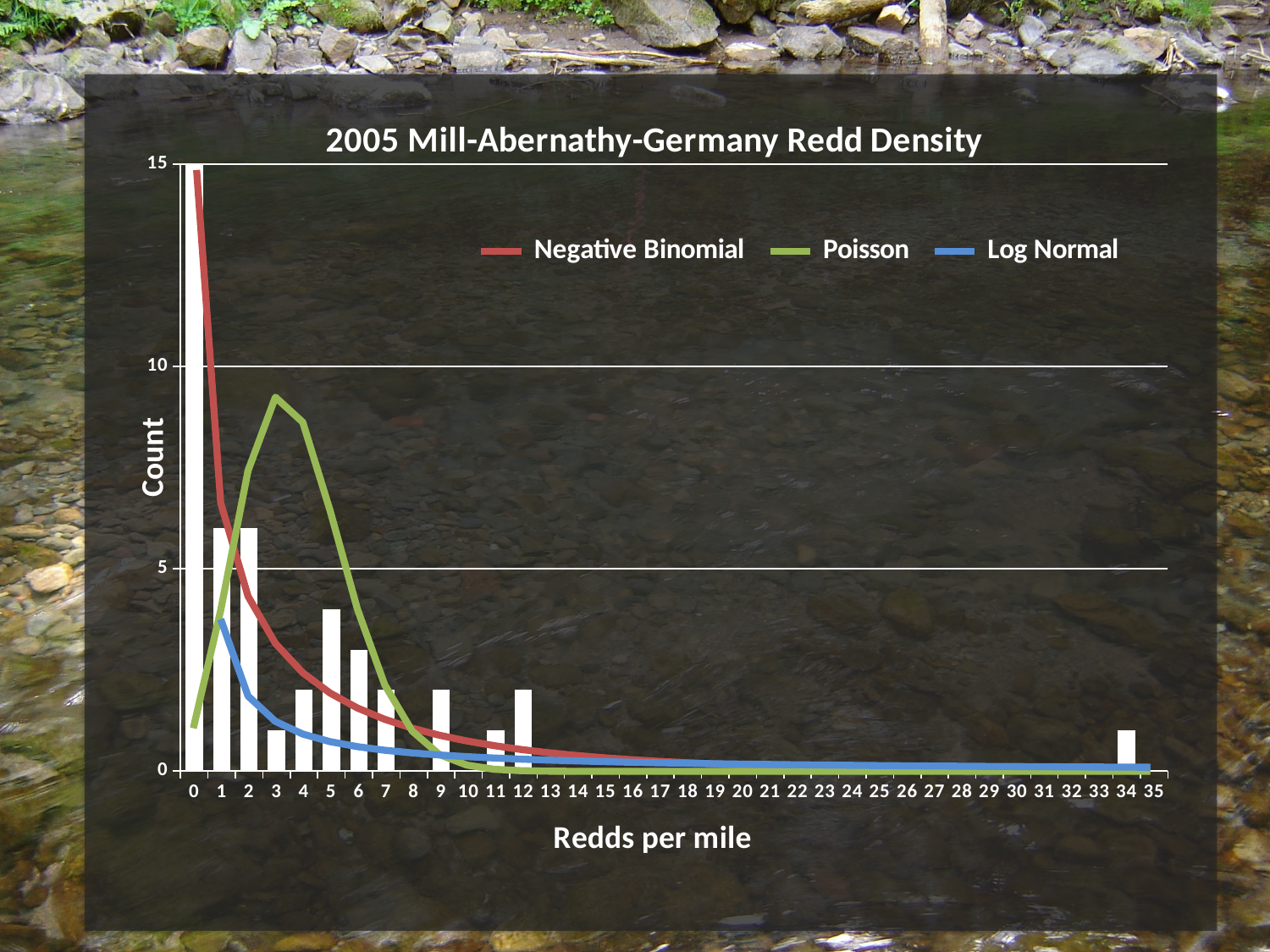
What is the label of the x axis? Redds per mile Which bar is taller, the one for 5 redds per mile or the one for 3 redds per mile? 5 redds per mile How many series does the legend list? 3 Does the Negative Binomial line rise or fall as redds per mile increase from 0 to 35? fall At which redds-per-mile value does the Poisson line reach its peak? 3 Is the bar for 0 redds per mile greater or less than 10? greater Is the bar for 5 redds per mile greater or less than 5? less Is the peak of the Poisson line greater or less than 10? less What is the title of the chart? 2005 Mill-Abernathy-Germany Redd Density Which bar is taller, the one for 1 redd per mile or the one for 6 redds per mile? 1 redd per mile Which redds-per-mile category has the tallest bar? 0